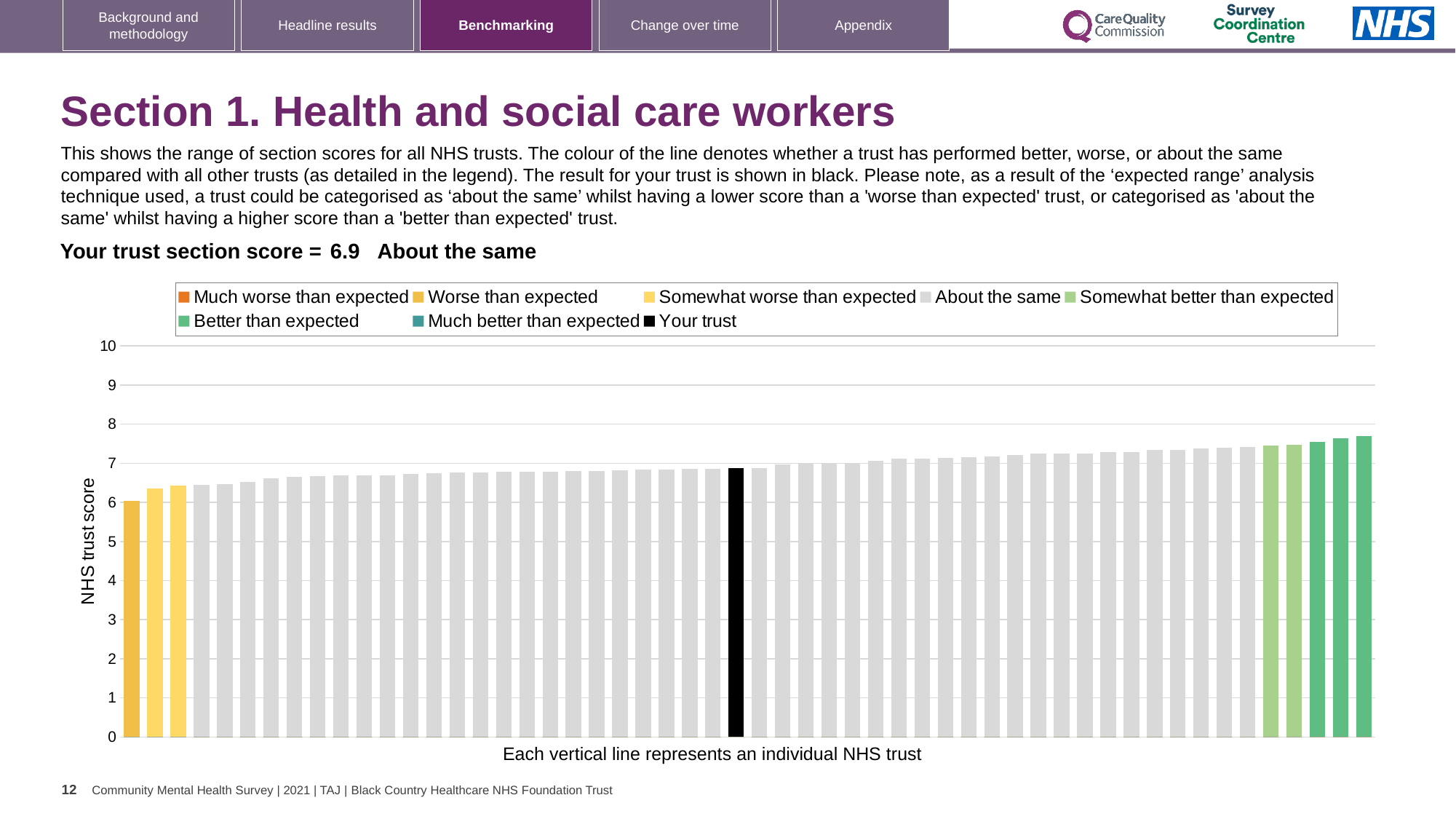
What kind of chart is shown on the slide? Bar chart Which legend category do the bars with the lowest scores belong to? Worse than expected Which legend category do the bars with the highest scores belong to? Better than expected How many entries does the chart legend list? 8 Which benchmarking category is your trust placed in for this section? About the same Is the value of the lowest bar in the chart greater or less than 5? greater What is the section score for your trust shown on the slide? 6.9 Is the value of the highest bar in the chart greater or less than 8? less Is the value for the black 'Your trust' bar greater or less than 5? greater What is the label on the vertical axis of the chart? NHS trust score Do the bar values rise or fall from left to right along the x axis? Rise How many bars are coloured as 'Worse than expected'? 1